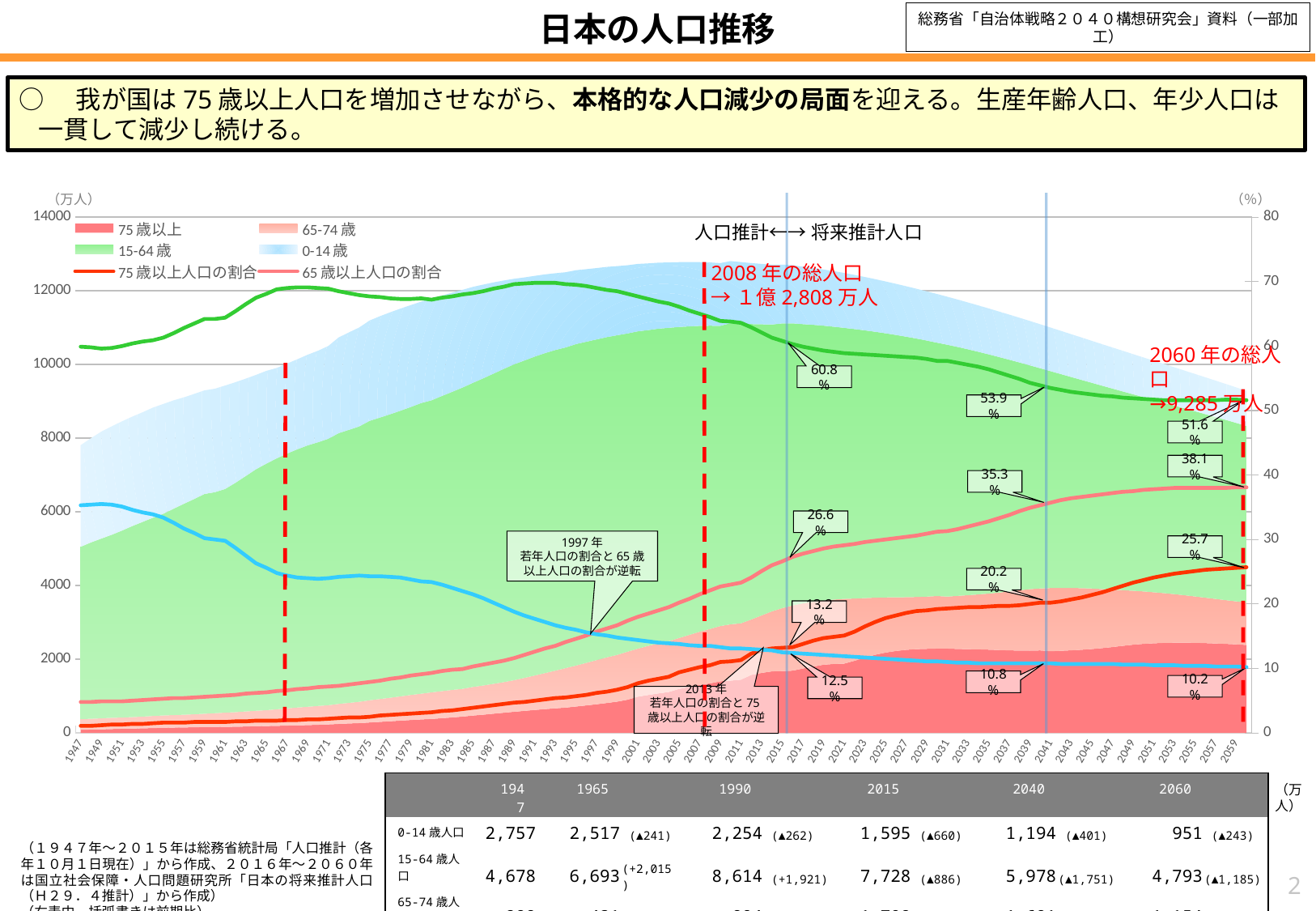
What kind of chart is shown on the slide? Stacked area chart with line series How many series does the chart legend list? 6 What is the value of 65歳以上人口の割合 labelled at 2040? 35.3% What is the value of 75歳以上人口の割合 labelled at 2060? 25.7% What is the value of 65歳以上人口の割合 labelled at 2015? 26.6% Does 75歳以上人口の割合 rise or fall from 1947 to 2060? Rise What is the value of 75歳以上人口の割合 labelled at 2015? 13.2% By how many percentage points does 65歳以上人口の割合 increase from 2015 (26.6%) to 2060 (38.1%)? 11.5 In 2040, which is larger: 65歳以上人口の割合 or 75歳以上人口の割合? 65歳以上人口の割合 According to the annotation, what was the total population in 2008? 1億2,808万人 What is the title of the slide's chart? 日本の人口推移 According to the annotation, what is the projected total population in 2060? 9,285万人